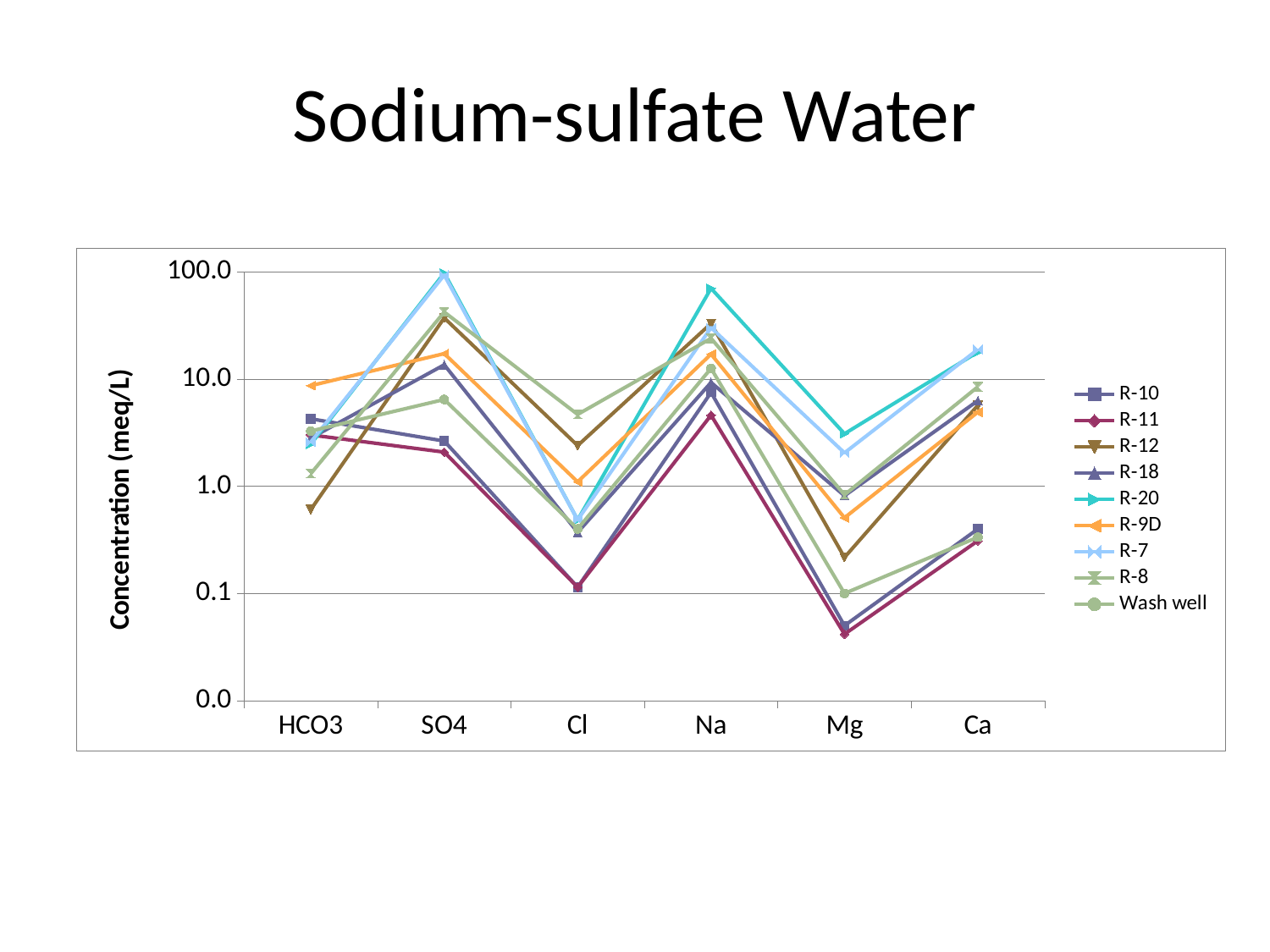
Is the value for R-10 at Ca greater or less than 1.0? less How many series does the chart's legend list? 9 What is the title of the slide containing the chart? Sodium-sulfate Water Is the value for R-11 at Mg greater or less than 0.1? less What is the label on the chart's vertical axis? Concentration (meq/L) At Mg, which series has the larger value, R-12 or R-9D? R-9D Is the value for R-20 at Na greater or less than 10.0? greater How many categories are shown on the x axis of the chart? 6 Which series has the highest value at Na? R-20 What kind of chart is shown on the slide? Line chart Which series has the lowest value at HCO3? R-12